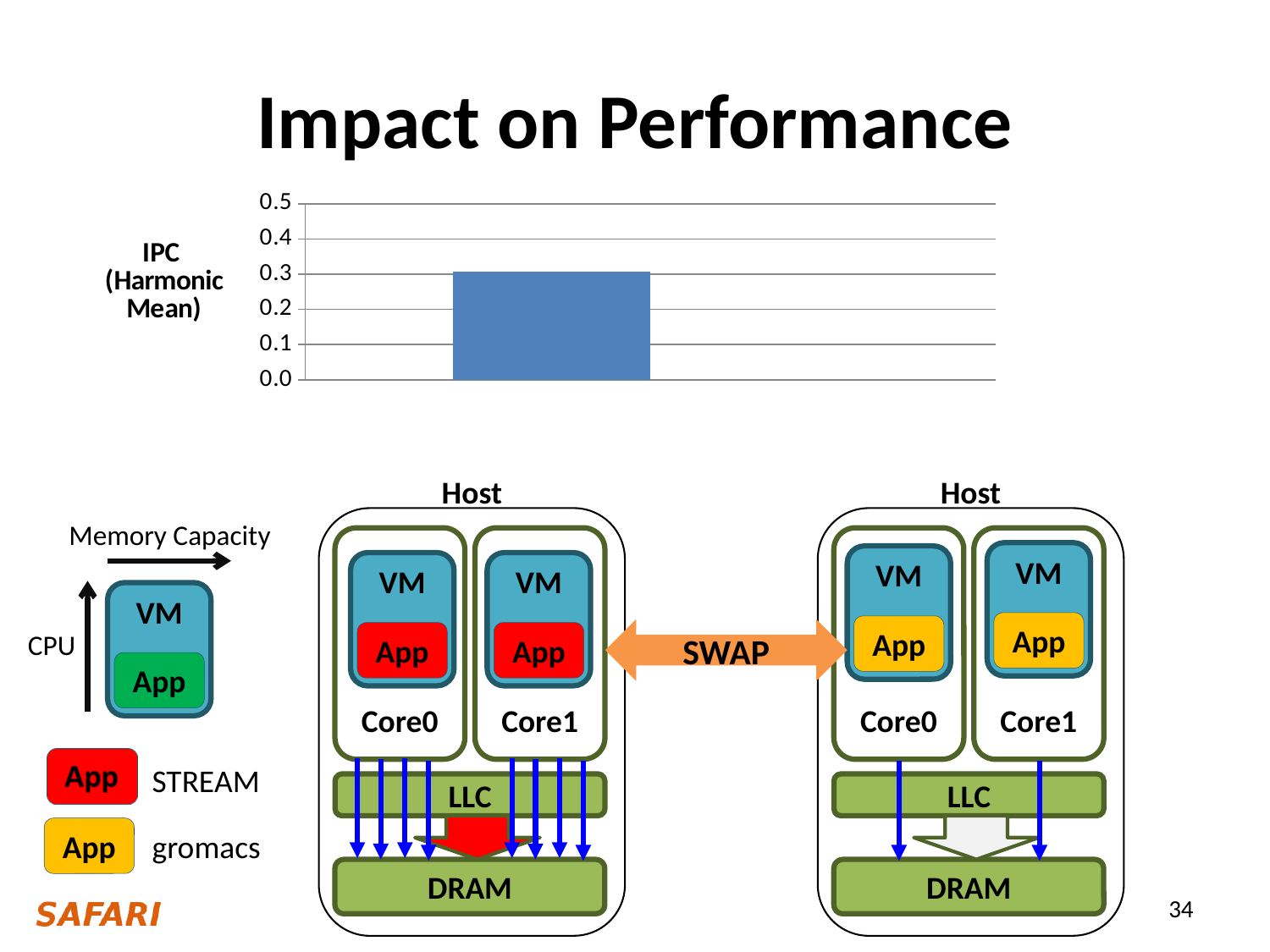
How many bars are plotted in the chart? 1 What kind of chart is shown on the slide? bar chart Is the value of the bar in the chart greater or less than 0.5? less What is the label of the vertical axis of the chart? IPC (Harmonic Mean) Is the value of the bar in the chart greater or less than 0.4? less Is the value of the bar in the chart greater or less than 0.1? greater What is the title of the slide containing the chart? Impact on Performance